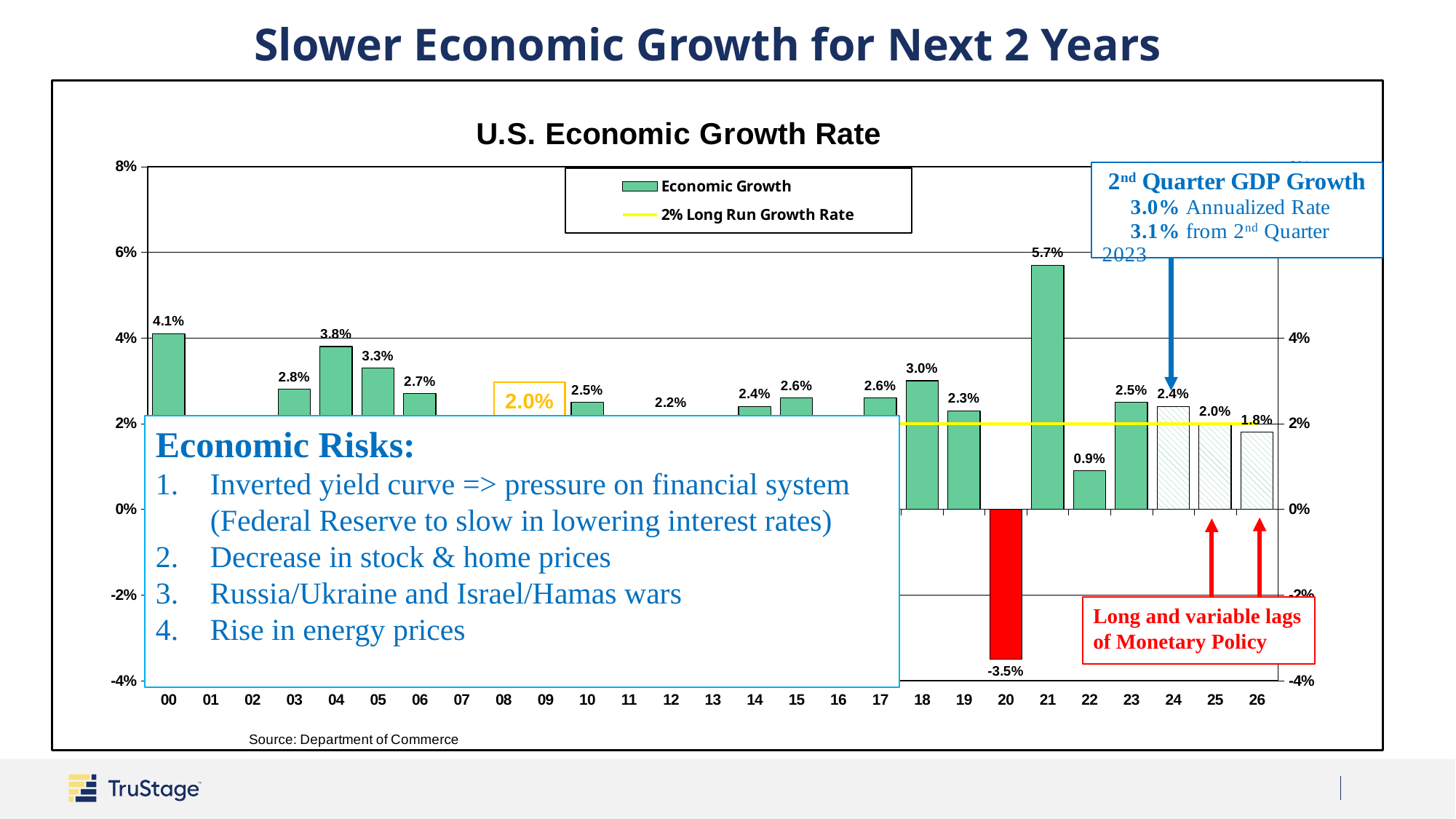
Which year has the higher growth rate, 04 or 05? 04 Do the growth rates rise or fall from 24 to 26? fall How many series does the chart legend list? 2 What is the economic growth rate shown for the year 20? -3.5% Which year has the lowest economic growth rate on the chart? 20 What is the difference between the growth rates for 21 and 22? 4.8 percentage points What is the economic growth rate shown for the year 21? 5.7% What kind of chart is used to show the U.S. Economic Growth Rate? bar chart What is the economic growth rate shown for the year 22? 0.9% What is the economic growth rate shown for the year 26? 1.8% Which year has the highest economic growth rate on the chart? 21 What is the economic growth rate shown for the year 00? 4.1%